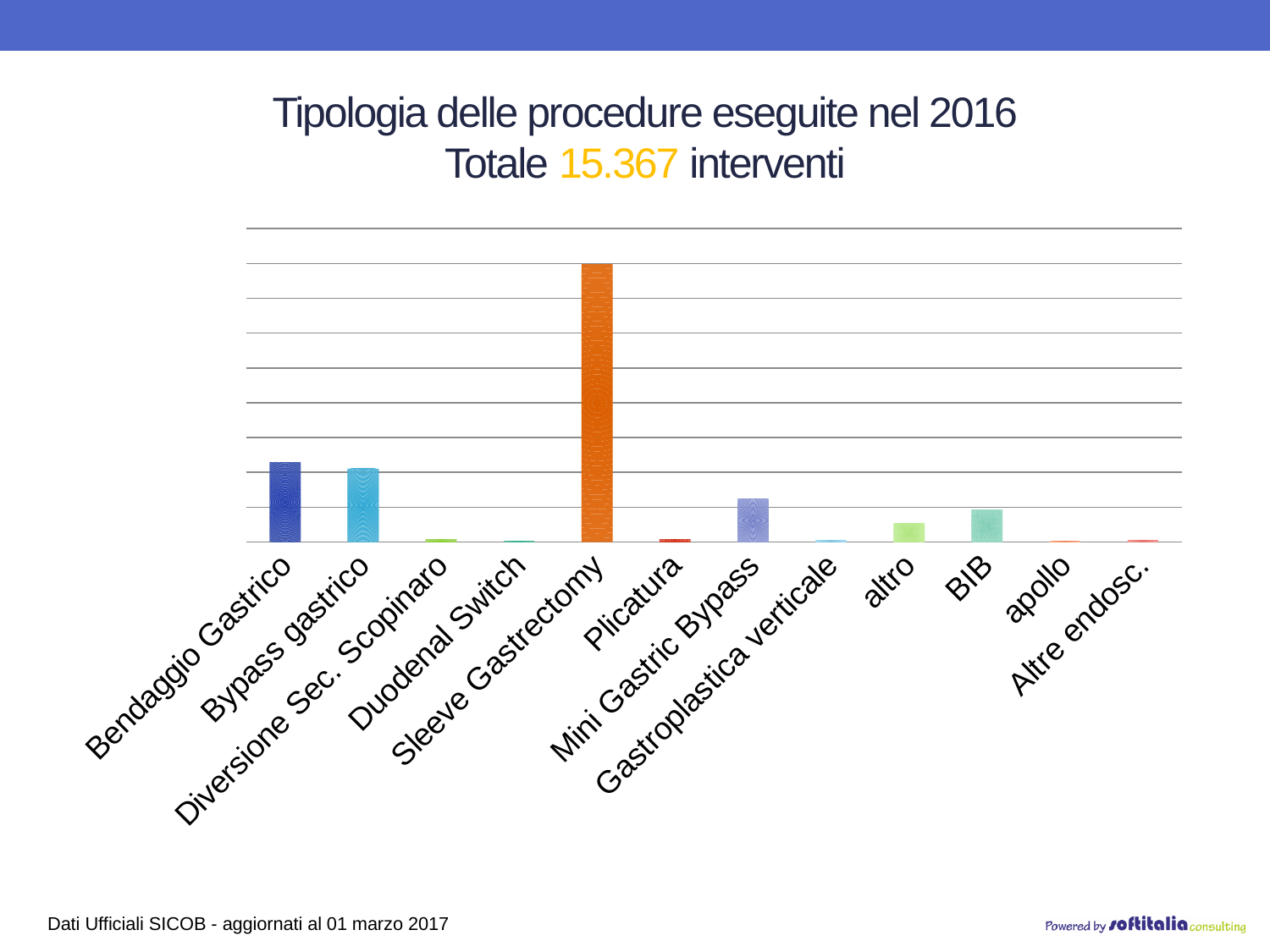
Which is larger, the value for Sleeve Gastrectomy or the value for Bypass gastrico? Sleeve Gastrectomy What colour is the bar for Sleeve Gastrectomy? orange What total number of interventions is stated in the chart title? 15.367 Which procedure has the highest bar in the chart? Sleeve Gastrectomy What kind of chart is shown on the slide? bar chart Which is larger, the value for Mini Gastric Bypass or the value for Plicatura? Mini Gastric Bypass Which is larger, the value for Bypass gastrico or the value for BIB? Bypass gastrico How many procedure categories are shown on the x axis? 12